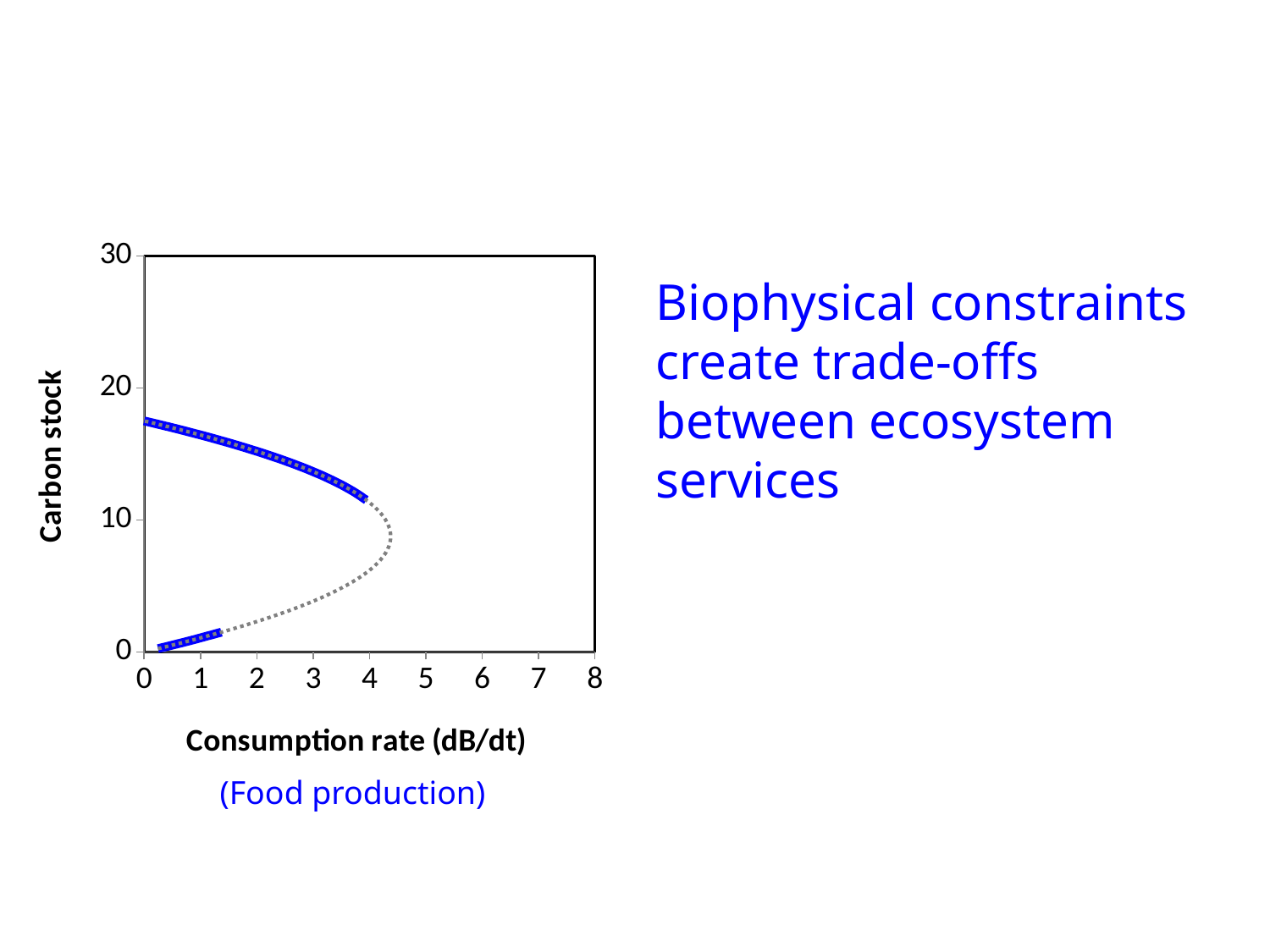
Along the upper solid blue branch of the curve, does carbon stock rise or fall as consumption rate increases from 0 to 4? fall Does the curve ever extend to a consumption rate greater or less than 6? less Is the carbon stock on the upper branch of the curve at a consumption rate of 0 greater or less than 10? greater Is the carbon stock on the upper branch of the curve at a consumption rate of 0 greater or less than 20? less What is the label of the y axis of the chart? Carbon stock What kind of chart is shown on the slide? line chart What is the label of the x axis of the chart? Consumption rate (dB/dt) What is the highest value shown on the x axis of the chart? 8 Which is larger: the carbon stock on the upper branch at a consumption rate of 1, or the carbon stock on the lower branch at a consumption rate of 1? upper branch